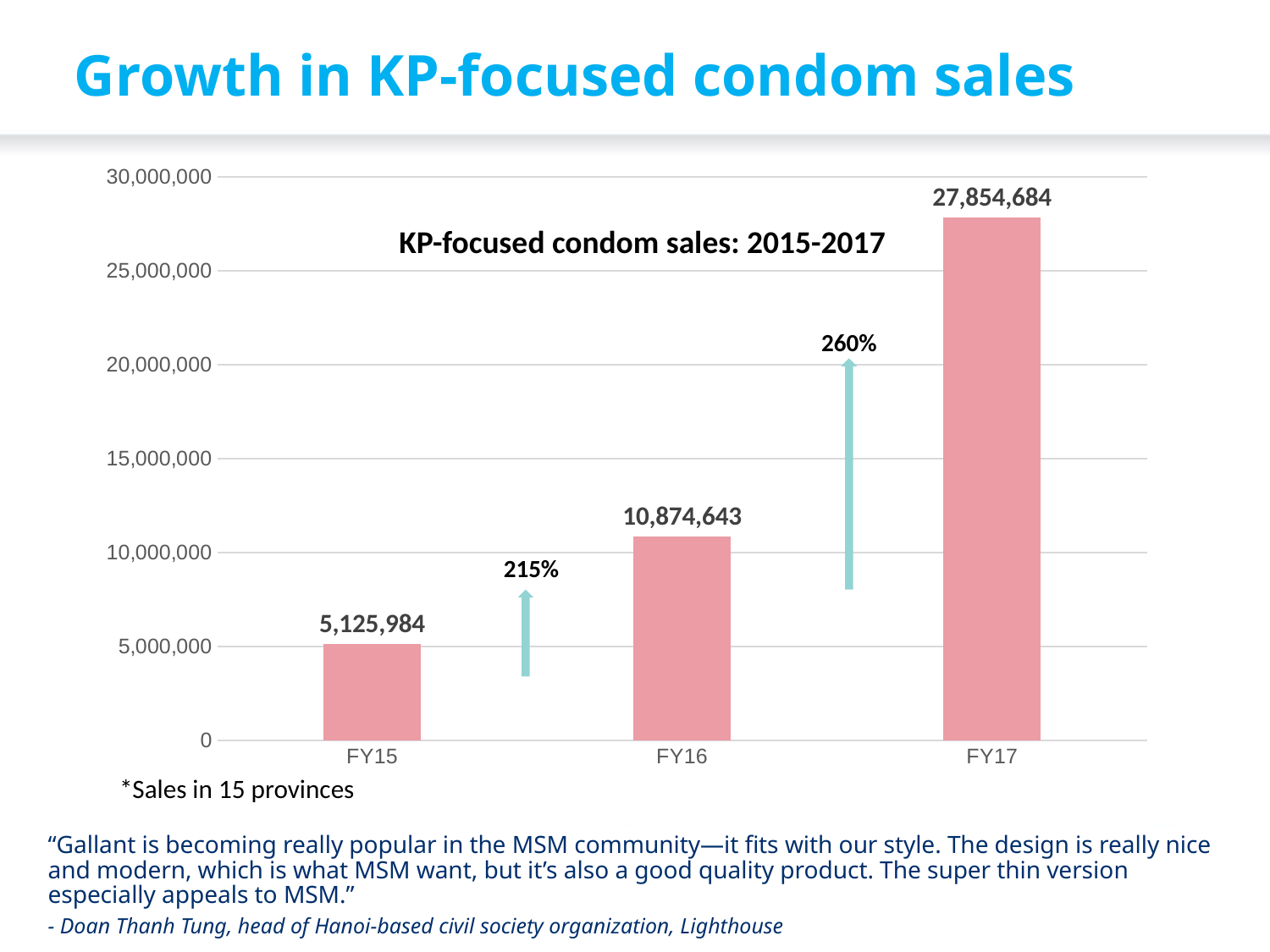
What is the value for FY16? 10,874,643 What is the value for FY15? 5,125,984 Which fiscal year has the lowest sales? FY15 Which fiscal year has the highest sales? FY17 Which is larger, the value for FY16 or the value for FY17? FY17 What is the difference between the FY16 and FY15 values? 5,748,659 What percentage growth is labelled between FY16 and FY17? 260% How many fiscal years are shown on the chart? 3 What kind of chart is shown on the slide? bar chart Is the value for FY16 greater or less than 10,000,000? greater What is the difference between the FY17 and FY16 values? 16,980,041 What is the value for FY17? 27,854,684